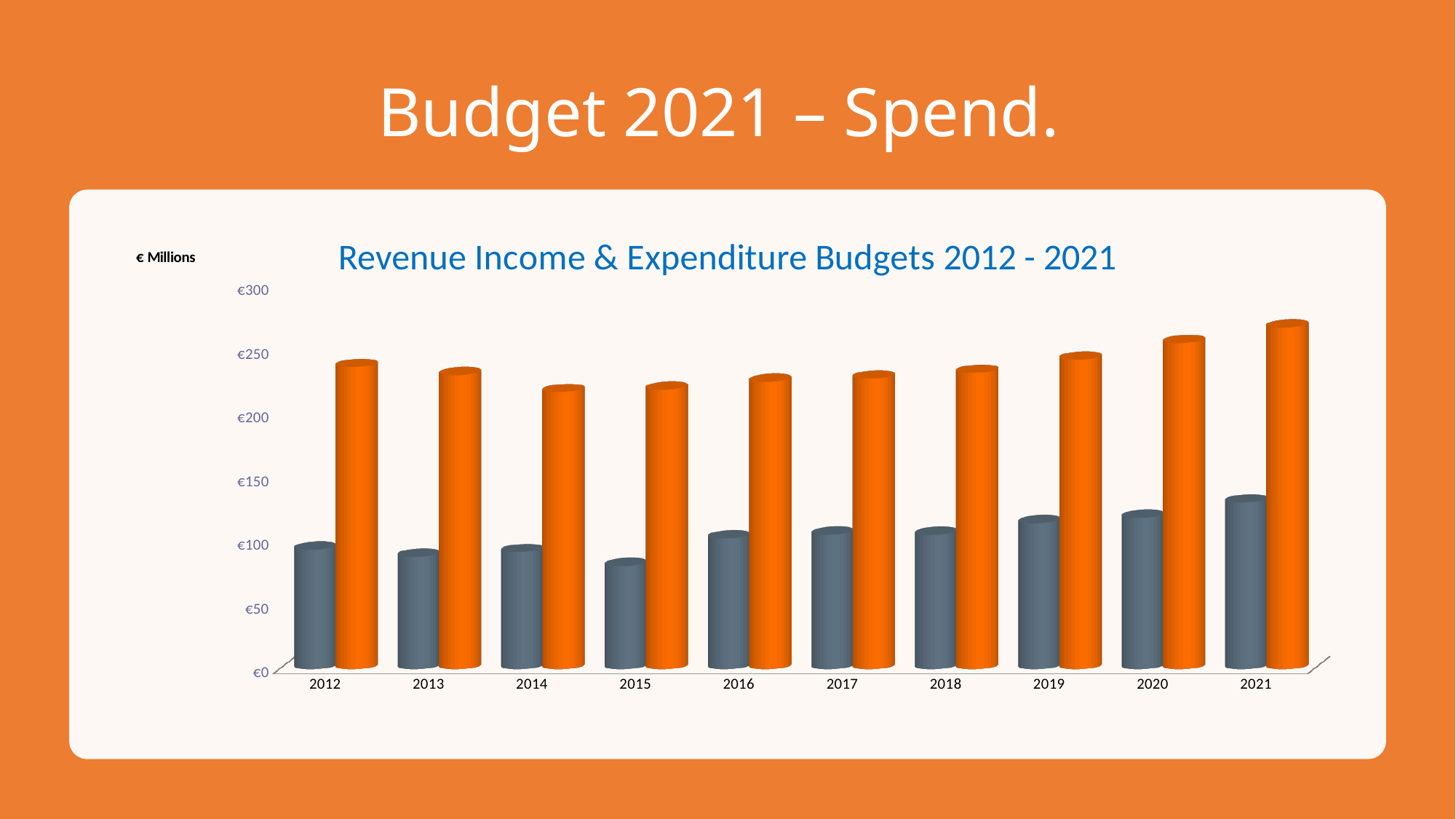
In which year is the grey bar the tallest? 2021 How many series of bars are plotted for each year? 2 What is the title of the chart? Revenue Income & Expenditure Budgets 2012 - 2021 What kind of chart is shown on the slide? bar chart Do the orange bars rise or fall from 2015 to 2021? rise Is the value of the grey bar for 2015 greater or less than €100? less Which is larger, the orange bar for 2021 or the orange bar for 2012? 2021 How many years are shown on the x axis of the chart? 10 Is the value of the grey bar for 2021 greater or less than €100? greater In which year is the grey bar the shortest? 2015 Is the value of the orange bar for 2021 greater or less than €250? greater In which year is the orange bar the tallest? 2021